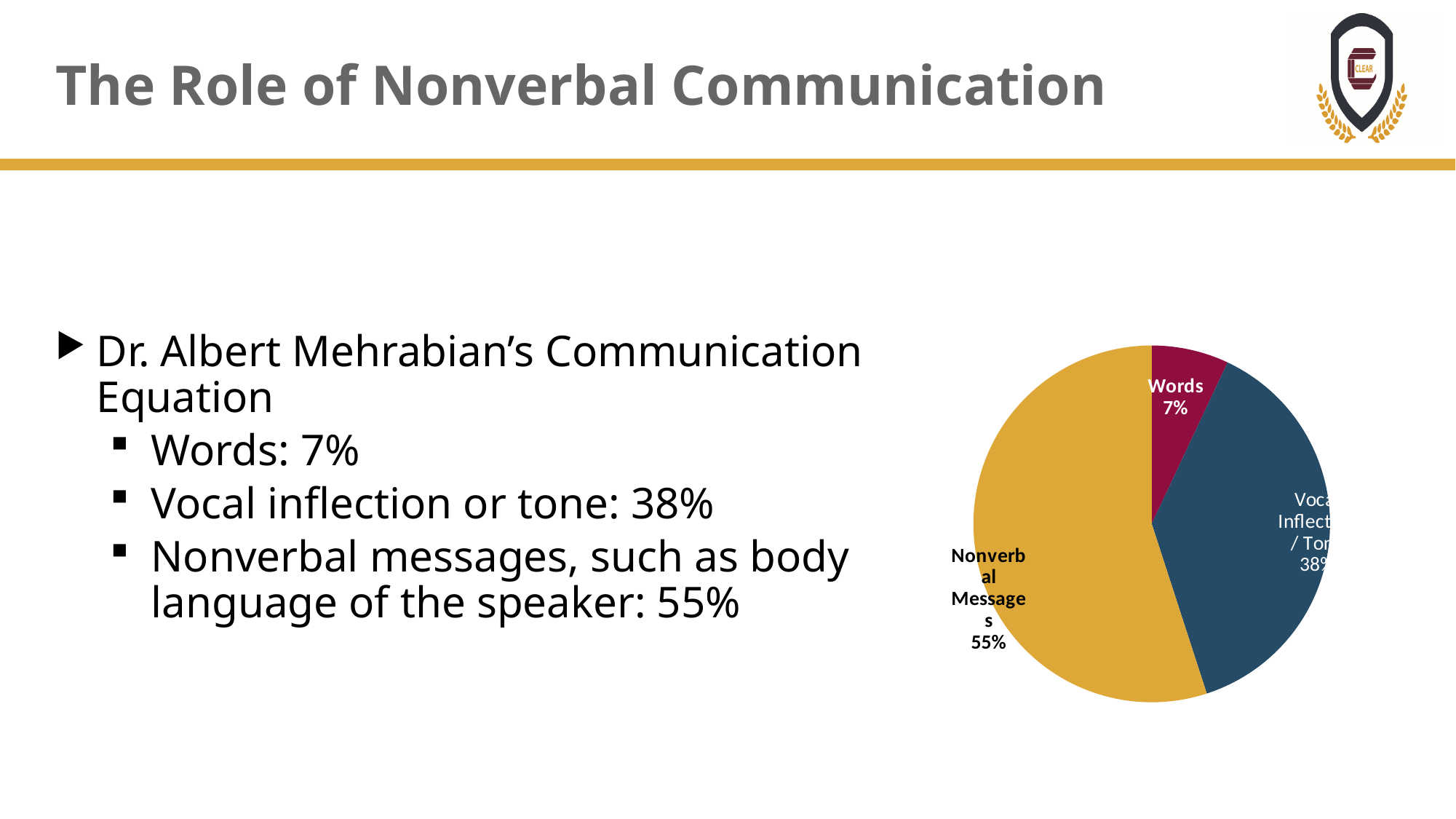
What kind of chart is shown on the slide? pie chart What is the difference between the Nonverbal Messages share and the Vocal Inflection / Tone share? 17% Which is larger, the Words slice or the Vocal Inflection / Tone slice? Vocal Inflection / Tone What colour is the Nonverbal Messages slice? gold What share of the pie does Words represent? 7% What colour is the Words slice? dark red How many slices does the pie chart have? 3 Which slice of the pie chart is the largest? Nonverbal Messages What share of the pie does Nonverbal Messages represent? 55% What share of the pie does Vocal Inflection / Tone represent? 38% What is the difference between the Vocal Inflection / Tone share and the Words share? 31% Which slice of the pie chart is the smallest? Words